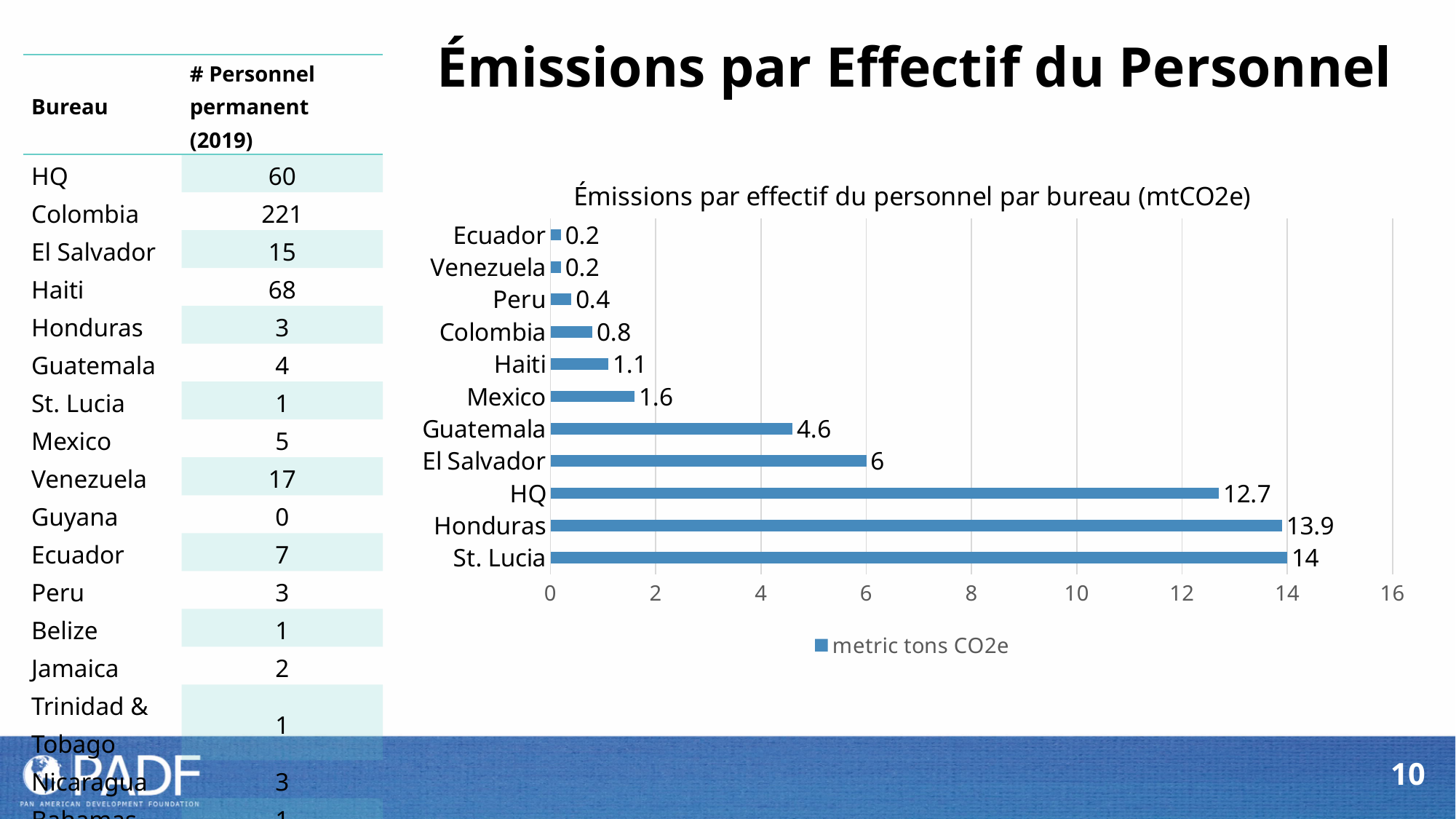
What is the value for HQ in the chart? 12.7 What is the difference between the values for Honduras and HQ? 1.2 What is the value for Guatemala in the chart? 4.6 Which bureau has the highest emissions per staff member in the chart? St. Lucia How many series does the chart legend list? 1 What is the value for Haiti in the chart? 1.1 What is the title of the chart? Émissions par effectif du personnel par bureau (mtCO2e) How many bureaus are shown in the chart? 11 Which is larger, the value for El Salvador or the value for Guatemala? El Salvador What is the legend entry of the chart? metric tons CO2e What kind of chart is shown on the slide? bar chart Is the value for Mexico greater or less than 2? less